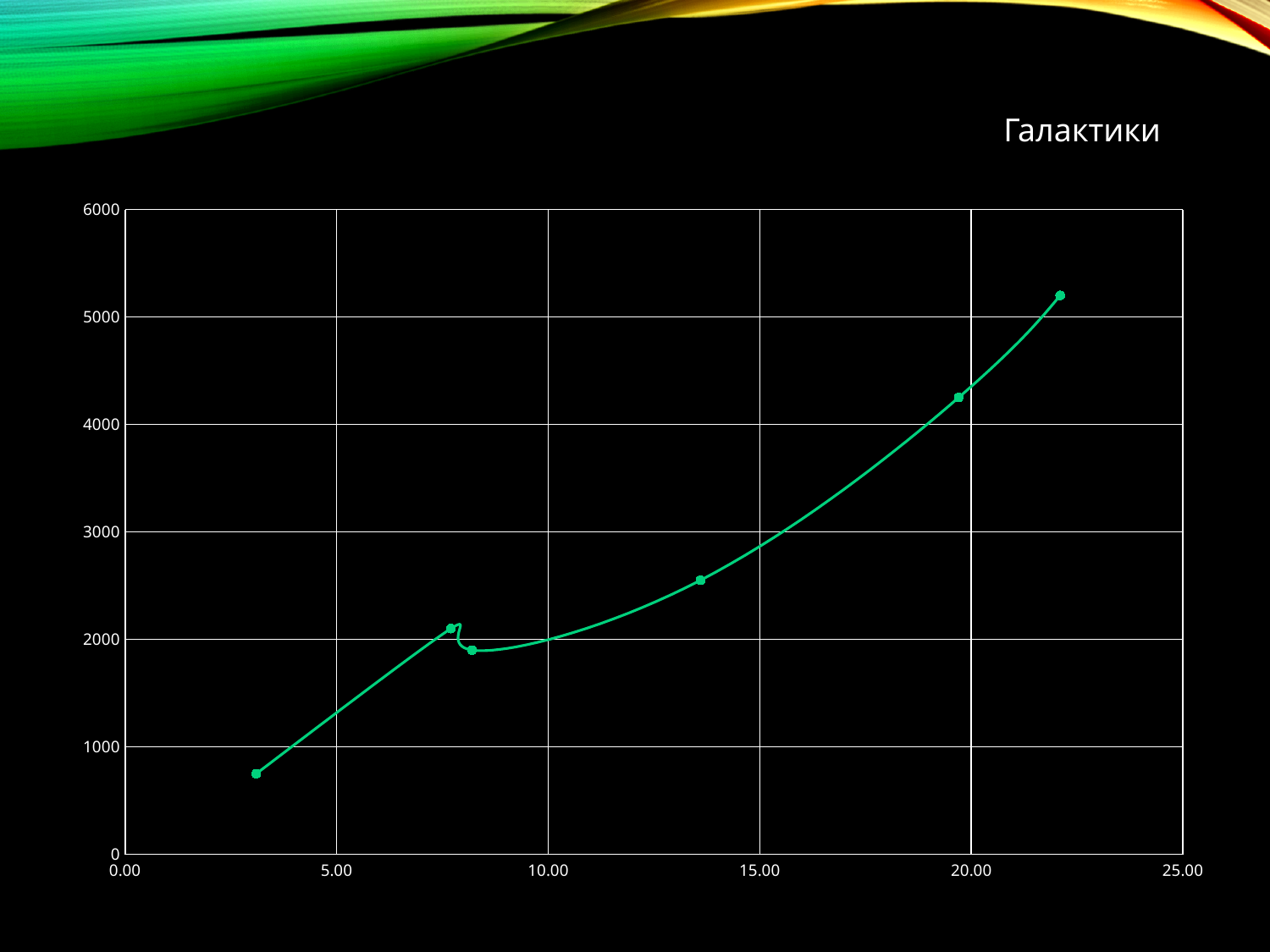
What is the maximum value shown on the vertical axis? 6000 Is the value of the rightmost (highest x) point greater or less than 5000? greater How many plotted points have a value above 3000? 2 Is the value of the point located between x = 10.00 and x = 15.00 greater or less than 2000? greater Do the plotted values generally rise or fall as the x value increases? rise How many data points are plotted on the chart? 6 Which point has the higher value: the leftmost point or the rightmost point? the rightmost point What kind of chart is shown on the slide? scatter chart Is the value of the leftmost (lowest x) point greater or less than 1000? less What is the title of the chart on the slide? Галактики